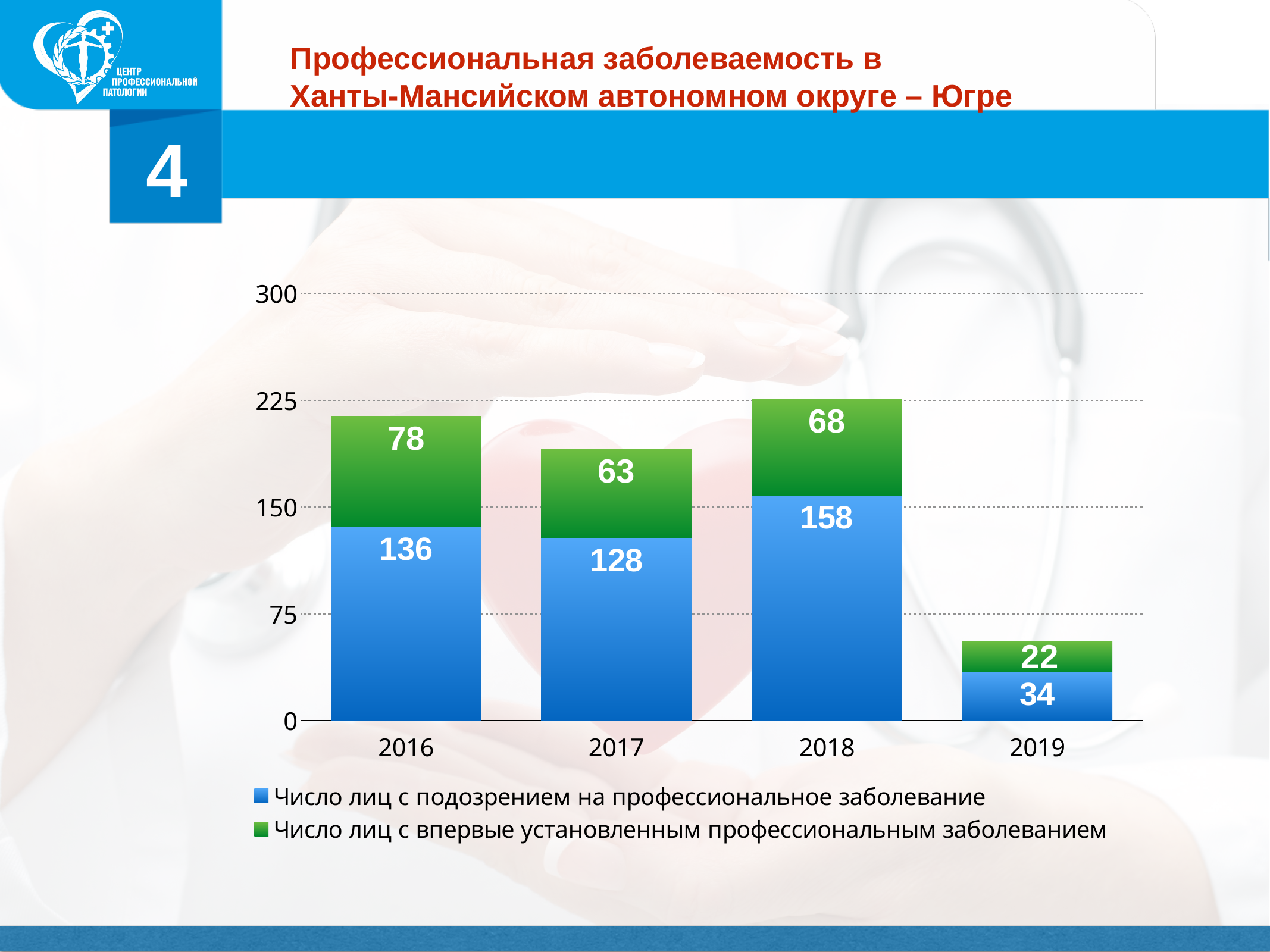
What kind of chart is shown on the slide? Stacked bar chart What is the number of persons with suspected occupational disease (Число лиц с подозрением на профессиональное заболевание) in 2018? 158 How many years are shown on the x axis? 4 Which is larger: the number of newly established occupational diseases in 2017 or in 2018? 2018 What is the difference between the number of suspected cases in 2016 and in 2017? 8 What is the total height of the stacked bar for 2019? 56 Which year has the highest number of persons with suspected occupational disease? 2018 What is the total height of the stacked bar for 2018? 226 Which year has the lowest number of persons with newly established occupational disease? 2019 What is the number of persons with newly established occupational disease (Число лиц с впервые установленным профессиональным заболеванием) in 2016? 78 How many series does the legend list? 2 What is the value of the blue series (suspected occupational disease) for 2019? 34